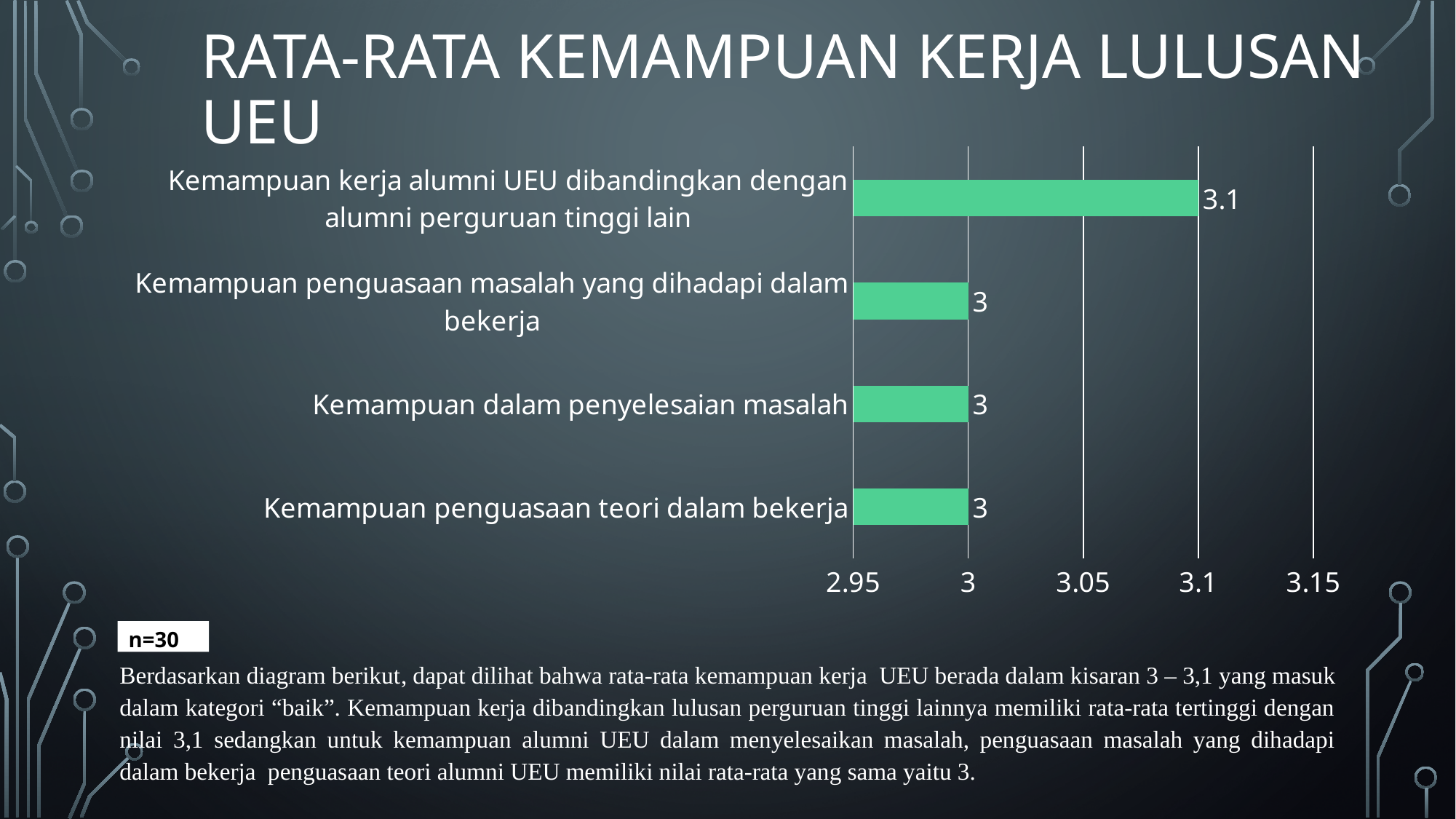
What sample size (n) is indicated on the slide? n=30 What is the value for 'Kemampuan penguasaan teori dalam bekerja'? 3 What is the value for 'Kemampuan penguasaan masalah yang dihadapi dalam bekerja'? 3 Is the value for 'Kemampuan kerja alumni UEU dibandingkan dengan alumni perguruan tinggi lain' greater or less than 3.05? greater How many categories are shown in the chart? 4 What is the difference between the value for 'Kemampuan kerja alumni UEU dibandingkan dengan alumni perguruan tinggi lain' and the value for 'Kemampuan penguasaan teori dalam bekerja'? 0.1 What kind of chart is shown on the slide? bar chart Which category has the highest value? Kemampuan kerja alumni UEU dibandingkan dengan alumni perguruan tinggi lain Which is larger: the value for 'Kemampuan kerja alumni UEU dibandingkan dengan alumni perguruan tinggi lain' or the value for 'Kemampuan dalam penyelesaian masalah'? Kemampuan kerja alumni UEU dibandingkan dengan alumni perguruan tinggi lain What is the title of the slide containing the chart? RATA-RATA KEMAMPUAN KERJA LULUSAN UEU What is the value for 'Kemampuan dalam penyelesaian masalah'? 3 What is the value for 'Kemampuan kerja alumni UEU dibandingkan dengan alumni perguruan tinggi lain'? 3.1